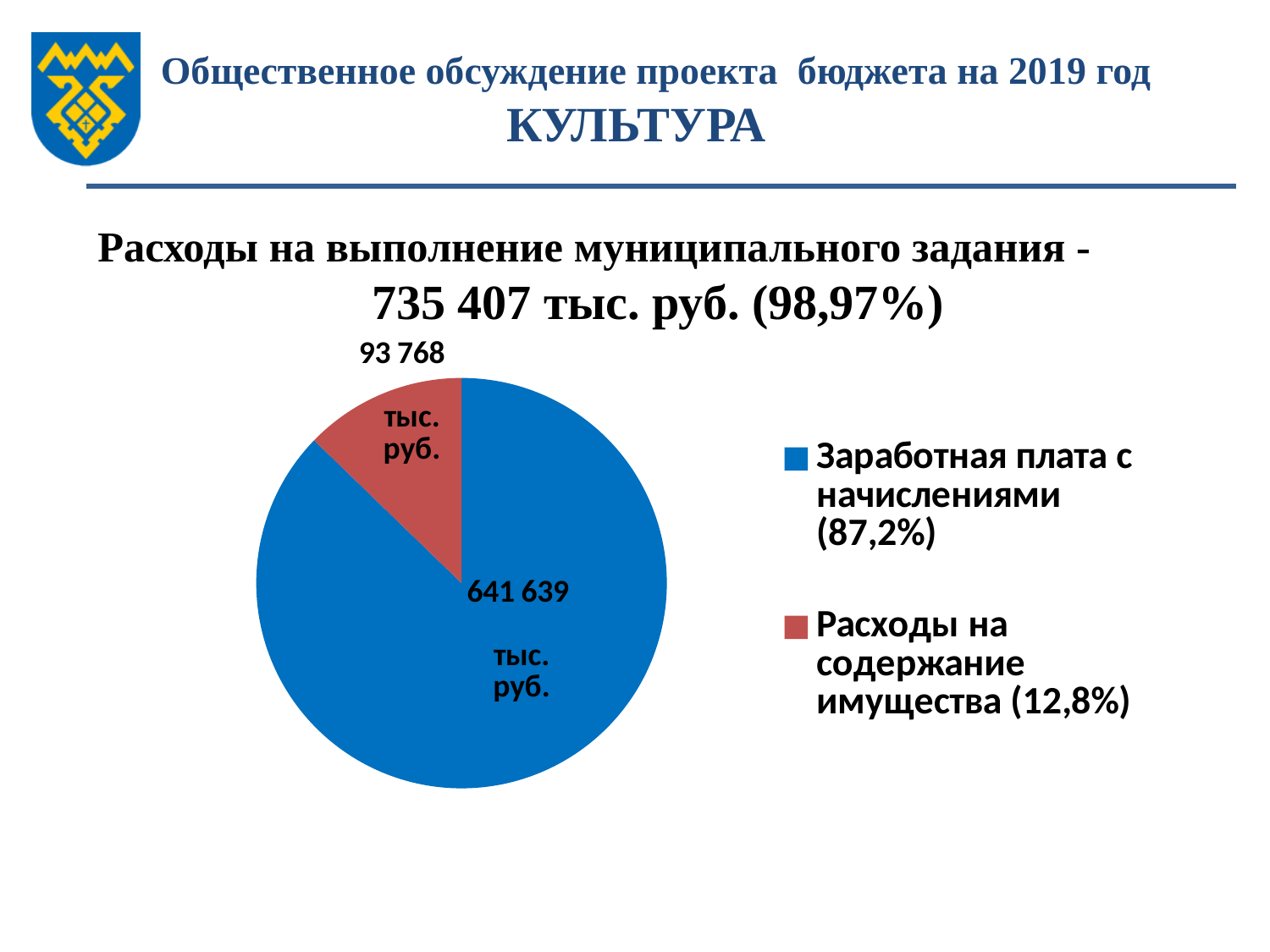
What is the value shown for 'Заработная плата с начислениями' in the pie chart? 641 639 тыс. руб. Which category has the largest slice in the pie chart? Заработная плата с начислениями How many slices does the pie chart have? 2 What colour is the slice for 'Расходы на содержание имущества' in the pie chart? red What is the value shown for 'Расходы на содержание имущества' in the pie chart? 93 768 тыс. руб. How many entries does the legend of the pie chart list? 2 What share of the pie does 'Заработная плата с начислениями' represent, according to the legend? 87,2% What kind of chart is shown on the slide? pie chart Which is larger: the value for 'Заработная плата с начислениями' or for 'Расходы на содержание имущества'? Заработная плата с начислениями What share of the pie does 'Расходы на содержание имущества' represent, according to the legend? 12,8% Which category has the smallest slice in the pie chart? Расходы на содержание имущества What is the difference between the values for 'Заработная плата с начислениями' and 'Расходы на содержание имущества'? 547 871 тыс. руб.